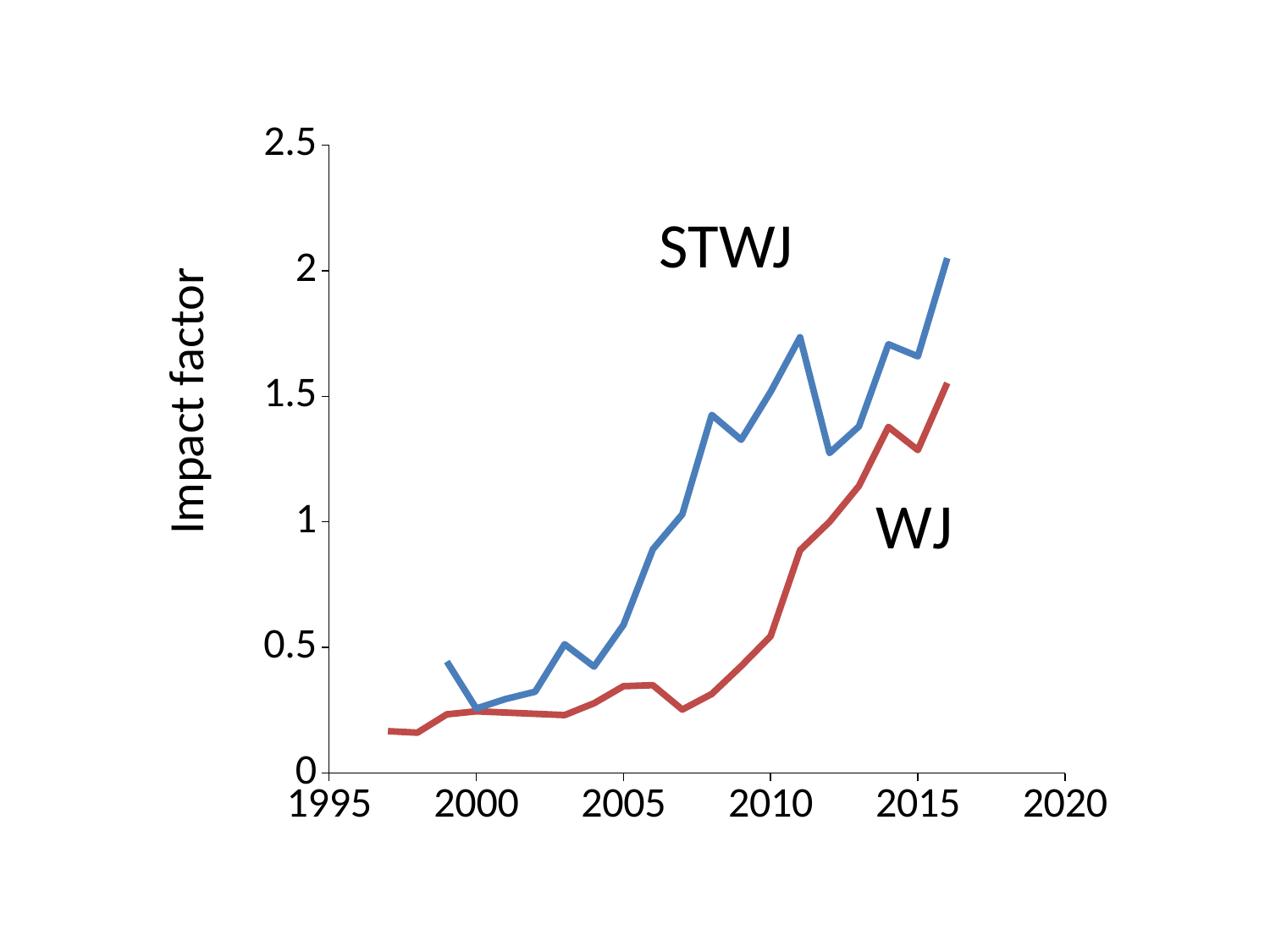
What kind of chart is shown on the slide? Line chart Is the impact factor for STWJ in 2011 greater or less than 1.5? greater Which series has the higher impact factor in 2010, STWJ or WJ? STWJ Is the impact factor for STWJ in 2016 greater or less than 1.5? greater Which series has the higher impact factor in 2016, STWJ or WJ? STWJ Which series reaches the highest impact factor on the chart? STWJ What is the label on the vertical axis of the chart? Impact factor What colour is the STWJ line? Blue Is the impact factor for WJ in 2005 greater or less than 0.5? less Overall, does the impact factor for WJ rise or fall from 1997 to 2016? Rise How many series are plotted on the chart? 2